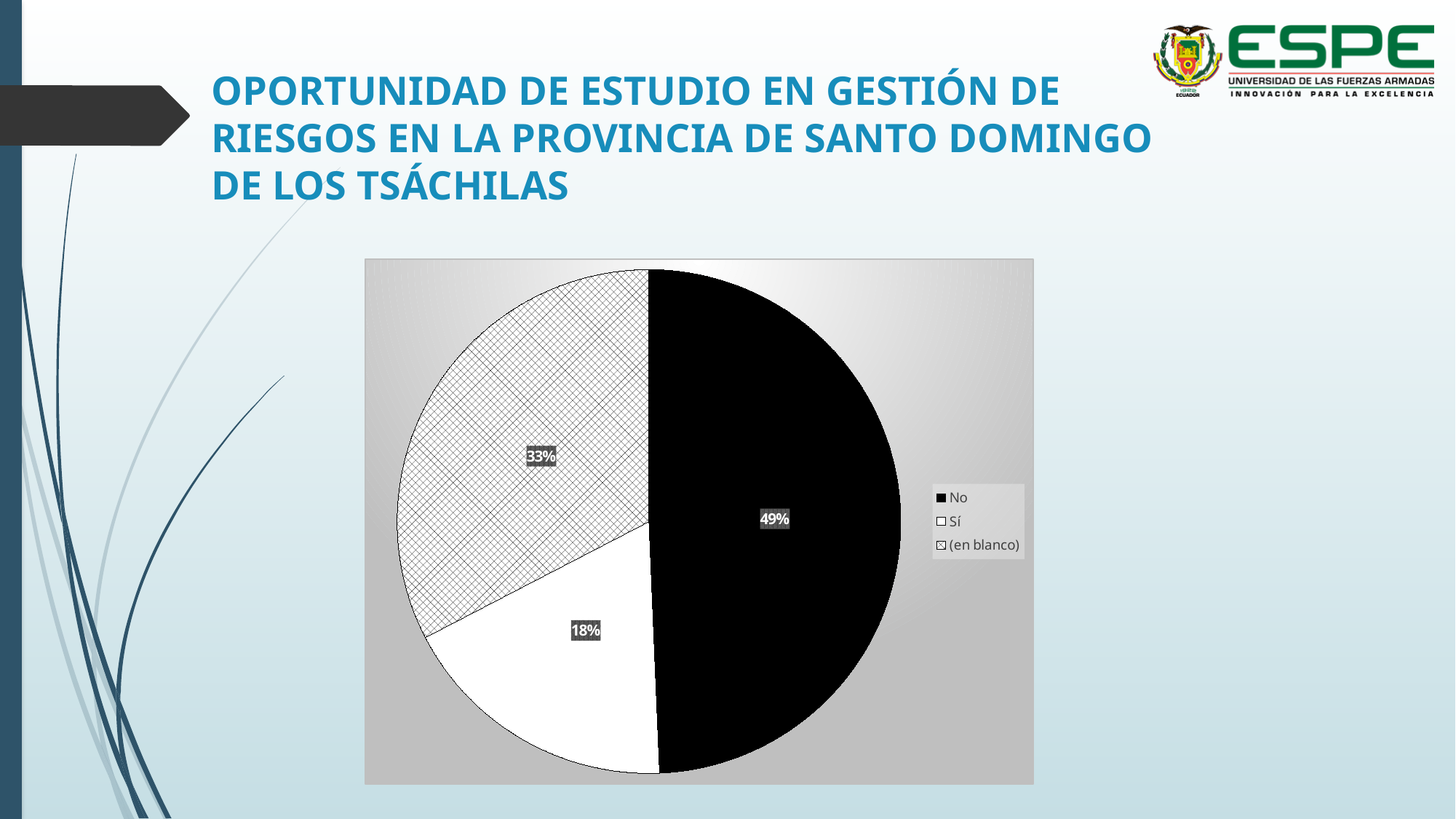
How many slices does the pie chart have? 3 How many entries does the legend list? 3 What kind of chart is shown on the slide? pie chart Which legend entry is shown with a cross-hatched pattern? (en blanco) What is the difference in percentage points between the "(en blanco)" slice and the "Sí" slice? 15 What share of the pie does the "Sí" slice represent? 18% What share of the pie does the "(en blanco)" slice represent? 33% What is the difference in percentage points between the "No" slice and the "Sí" slice? 31 What share of the pie does the "No" slice represent? 49% Which category has the largest slice of the pie? No Which is larger, the "(en blanco)" slice or the "Sí" slice? (en blanco) Which category has the smallest slice of the pie? Sí